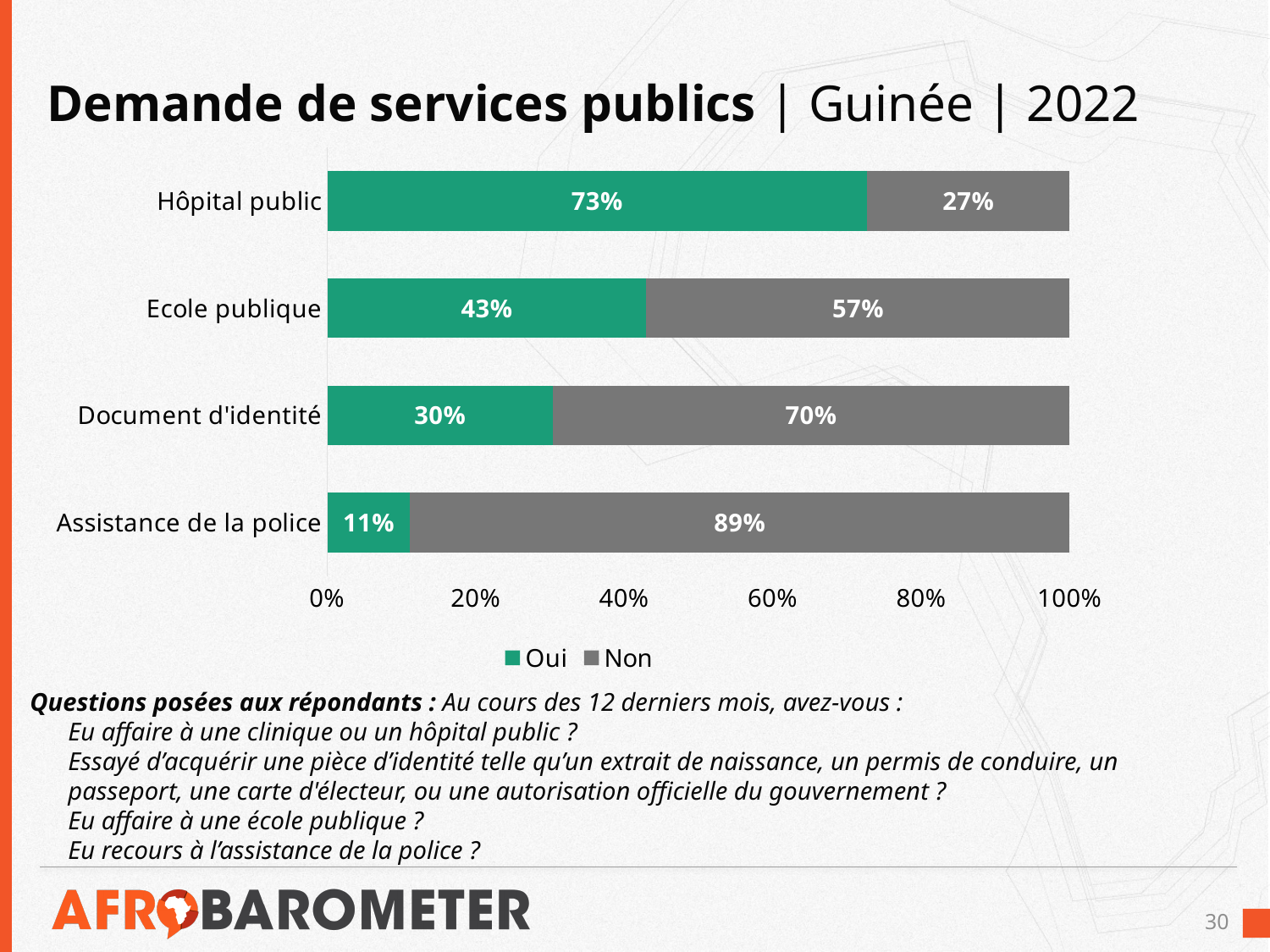
What is the 'Oui' value for Hôpital public? 73% What is the 'Oui' value for Document d'identité? 30% What is the total of the stacked bar for Document d'identité? 100% How many categories are shown on the chart? 4 What kind of chart is shown on the slide? Stacked bar chart Which is larger: the 'Oui' value for Ecole publique or the 'Oui' value for Document d'identité? Ecole publique Which category has the highest 'Oui' value? Hôpital public What is the 'Non' value for Ecole publique? 57% Which category has the lowest 'Oui' value? Assistance de la police What is the 'Non' value for Assistance de la police? 89% What is the difference between the 'Oui' values for Hôpital public and Ecole publique? 30 percentage points How many series does the legend list? 2